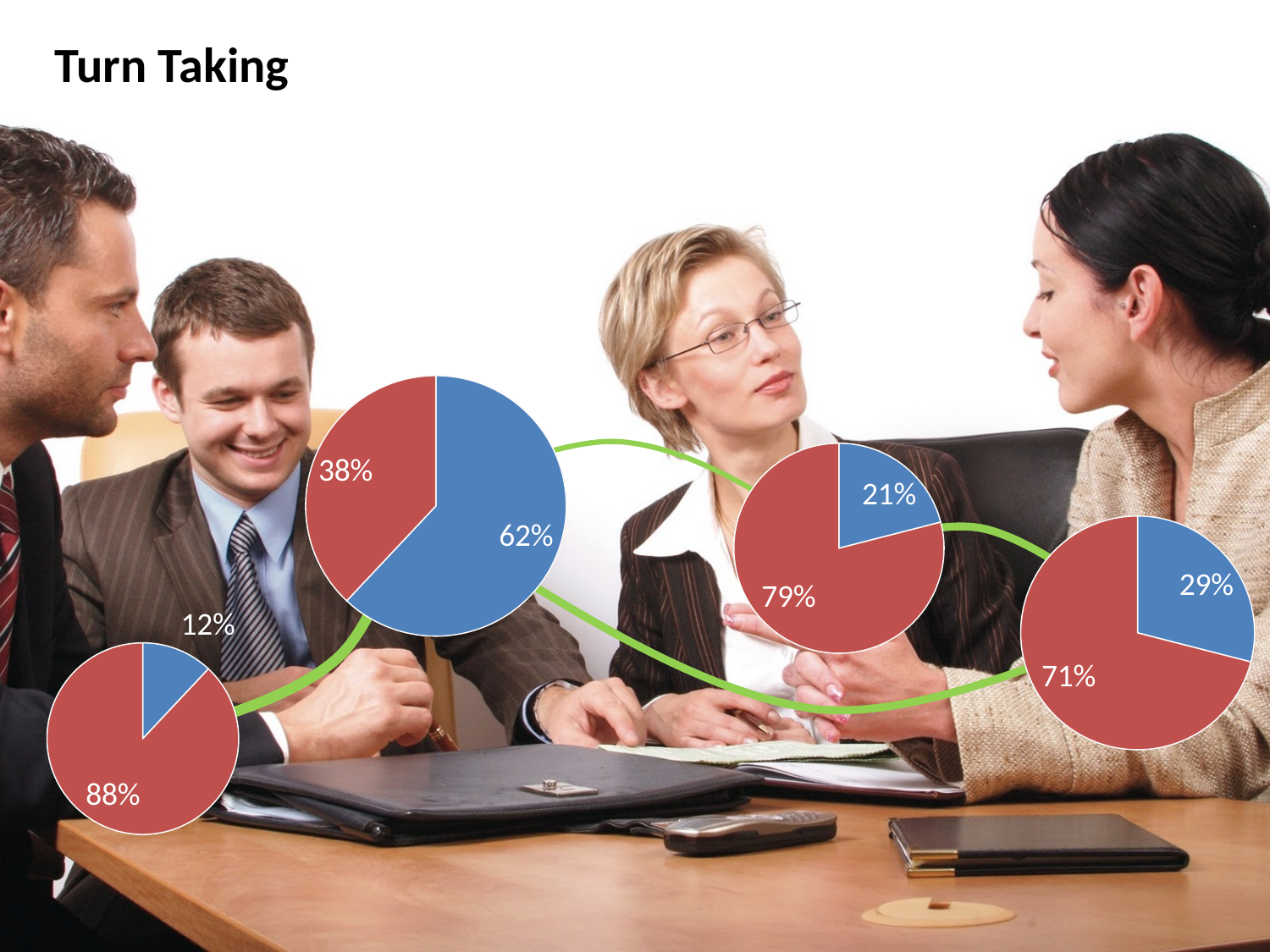
How many pie charts are on the slide? 4 What kind of charts are shown on the slide? Pie charts In the leftmost pie chart, what value is shown on the red slice? 88% Is the blue slice larger in the third pie chart from the left or in the rightmost pie chart? The rightmost pie chart How many slices does each pie chart have? 2 Across the four pie charts, which pie has the largest blue slice? The second pie chart from the left (62%) In the rightmost pie chart, what value is shown on the blue slice? 29% In the second pie chart from the left, what value is shown on the blue slice? 62% In the third pie chart from the left, what value is shown on the red slice? 79% Across the four pie charts, which pie has the smallest blue slice? The leftmost pie chart (12%) In the leftmost pie chart, what value is shown on the blue slice? 12% In the second pie chart from the left, what is the difference between the blue slice and the red slice? 24%